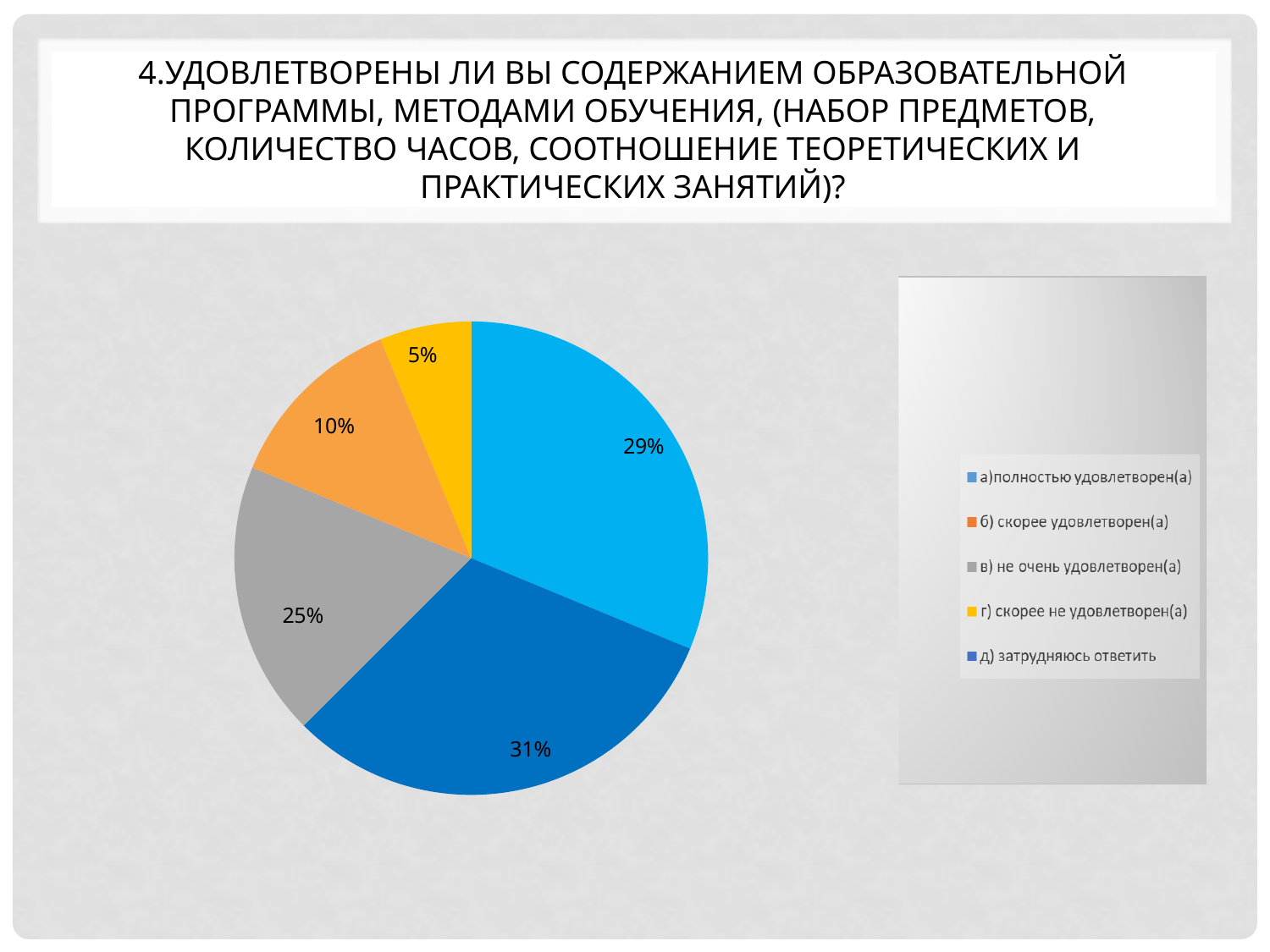
What share of the pie is labelled for 'г) скорее не удовлетворен(а)'? 5% What share of the pie is labelled for 'в) не очень удовлетворен(а)'? 25% What is the difference in percentage points between the 'д) затрудняюсь ответить' slice and the 'а)полностью удовлетворен(а)' slice? 2% What share of the pie is labelled for 'б) скорее удовлетворен(а)'? 10% How many slices does the pie chart have? 5 What kind of chart is shown on the slide? pie chart Which slice is larger: 'в) не очень удовлетворен(а)' or 'б) скорее удовлетворен(а)'? в) не очень удовлетворен(а) Which legend category has the largest slice of the pie? д) затрудняюсь ответить Which legend category has the smallest slice of the pie? г) скорее не удовлетворен(а) How many entries does the legend list? 5